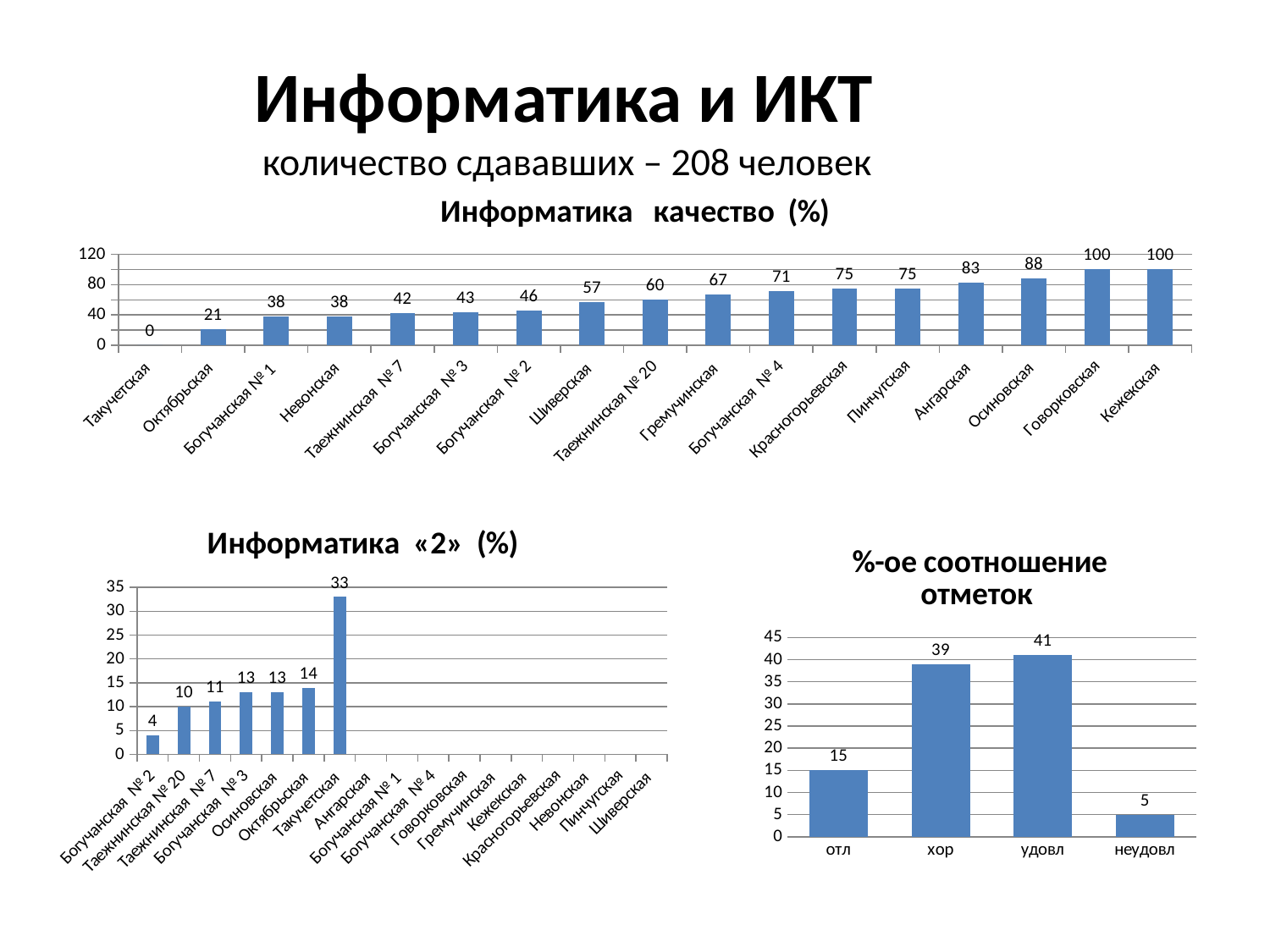
In the chart "%-ое соотношение отметок", what is the value for хор? 39 In the chart "Информатика качество (%)", which category has the lowest value? Такучетская In the chart "Информатика качество (%)", how many categories are shown on the x axis? 17 In the chart "Информатика качество (%)", what is the value for Октябрьская? 21 What type of chart is "%-ое соотношение отметок"? bar chart In the chart "Информатика «2» (%)", which category has the highest value? Такучетская In the chart "Информатика «2» (%)", what is the difference between the values for Такучетская and Октябрьская? 19 In the chart "Информатика «2» (%)", what is the value for Таежнинская № 7? 11 In the chart "%-ое соотношение отметок", which category has the lowest value? неудовл In the chart "Информатика качество (%)", what is the difference between the values for Осиновская and Ангарская? 5 In the chart "Информатика качество (%)", what is the value for Гремучинская? 67 In the chart "Информатика качество (%)", which is larger, the value for Шиверская or the value for Богучанская № 2? Шиверская